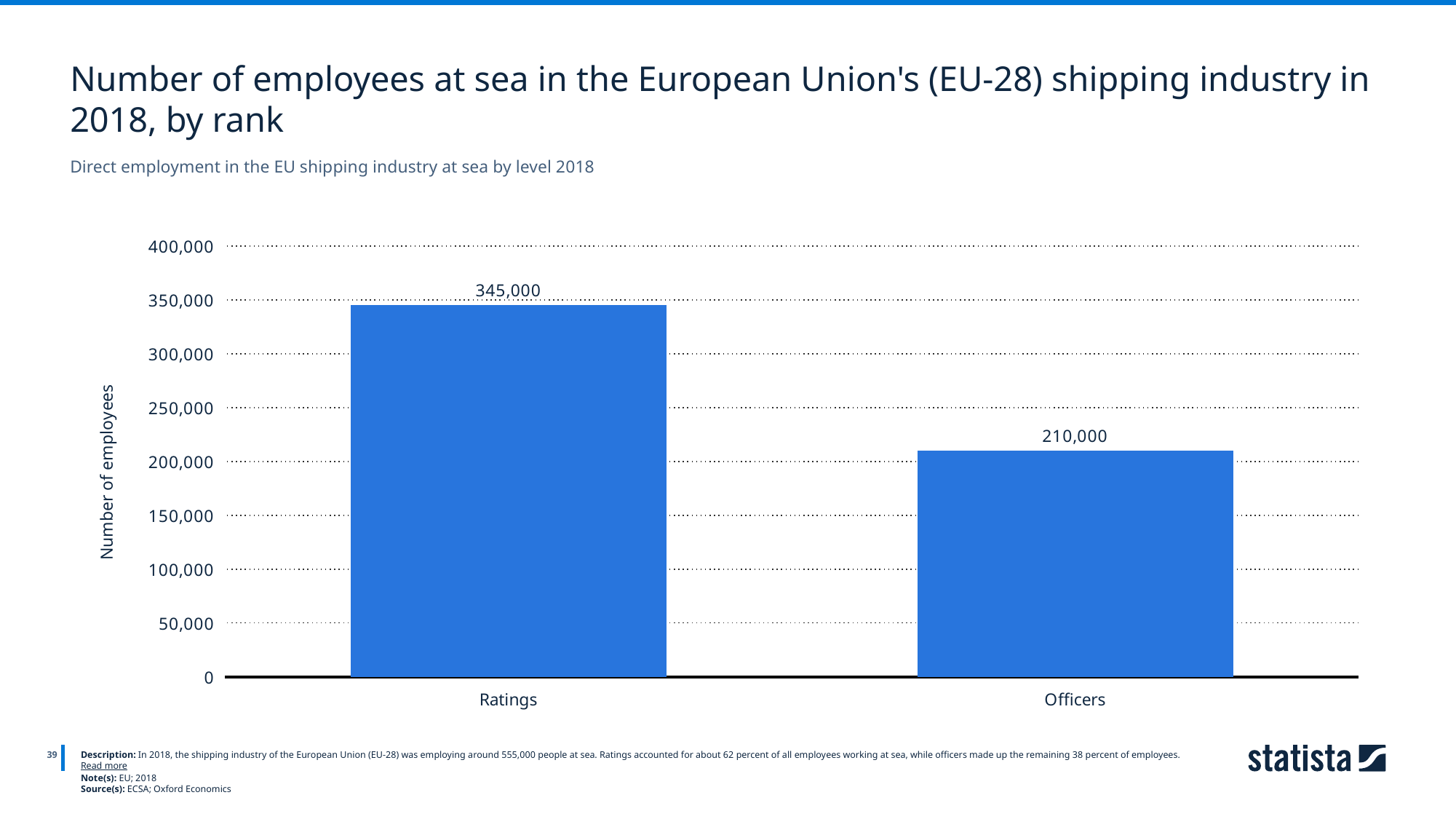
What kind of chart is shown on the slide? Bar chart Is the value for Officers greater or less than 250,000? less How many rank categories are shown in the chart? 2 What is the total number of employees across both ranks shown in the chart? 555,000 What is the number of employees at sea for Officers? 210,000 Which rank has the highest number of employees at sea? Ratings What is the label of the vertical axis? Number of employees What is the difference in the number of employees between Ratings and Officers? 135,000 Is the value for Ratings greater or less than 300,000? greater Which rank has the lowest number of employees at sea? Officers What is the number of employees at sea for Ratings? 345,000 Which has more employees at sea, Ratings or Officers? Ratings